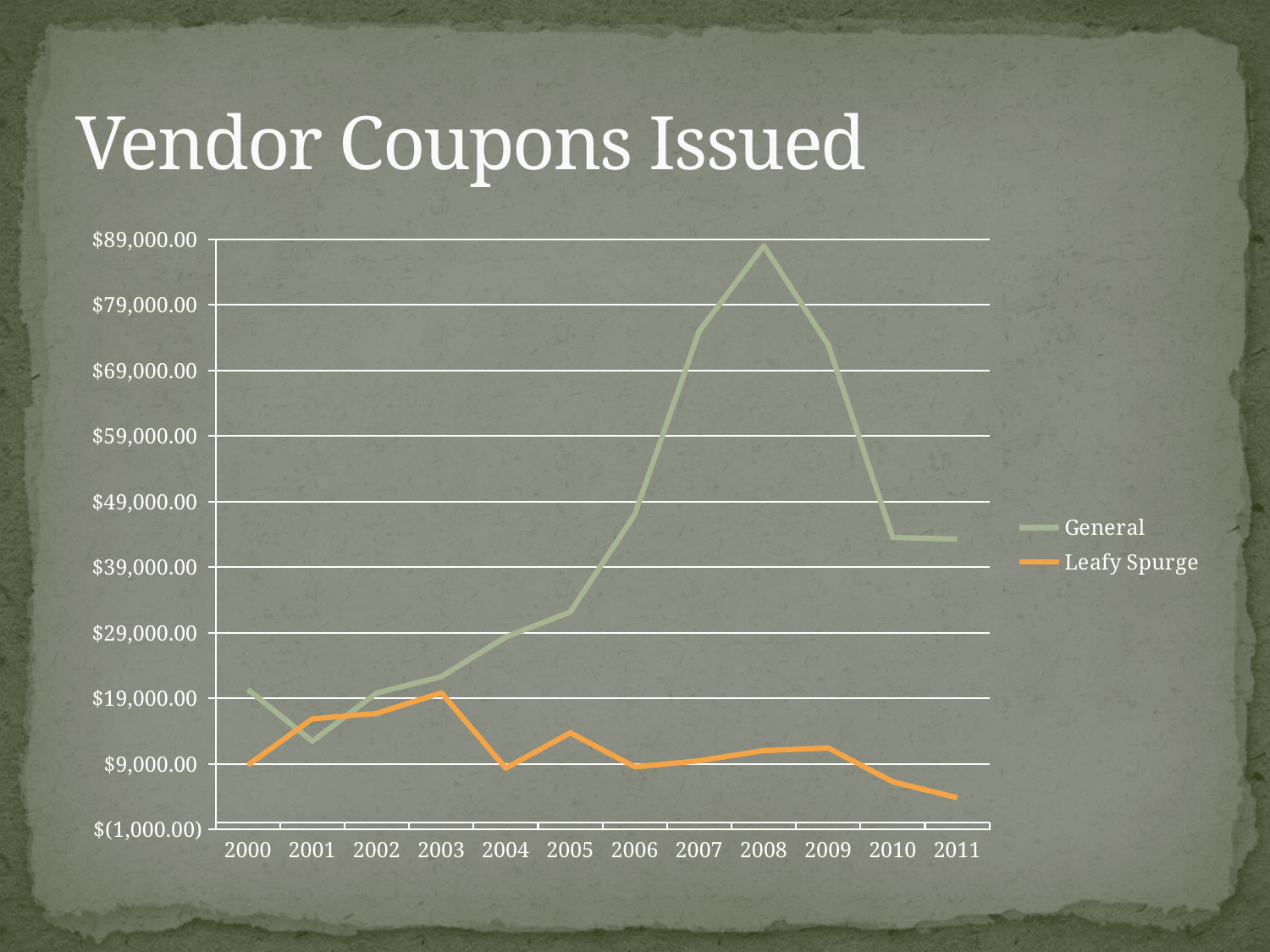
In which year does the General series reach its highest value? 2008 How many series does the legend list? 2 Is the Leafy Spurge value for 2011 greater or less than $9,000.00? less How many years are shown along the x axis? 12 In which year does the General series have its lowest value? 2001 In which year does the Leafy Spurge series reach its highest value? 2003 What is the title of the chart? Vendor Coupons Issued What kind of chart is shown on the slide? Line chart Is the General value for 2008 greater or less than $79,000.00? greater Does the General series rise or fall from 2005 to 2008? Rise In which year does the Leafy Spurge series have its lowest value? 2011 In 2008, which series has the larger value, General or Leafy Spurge? General